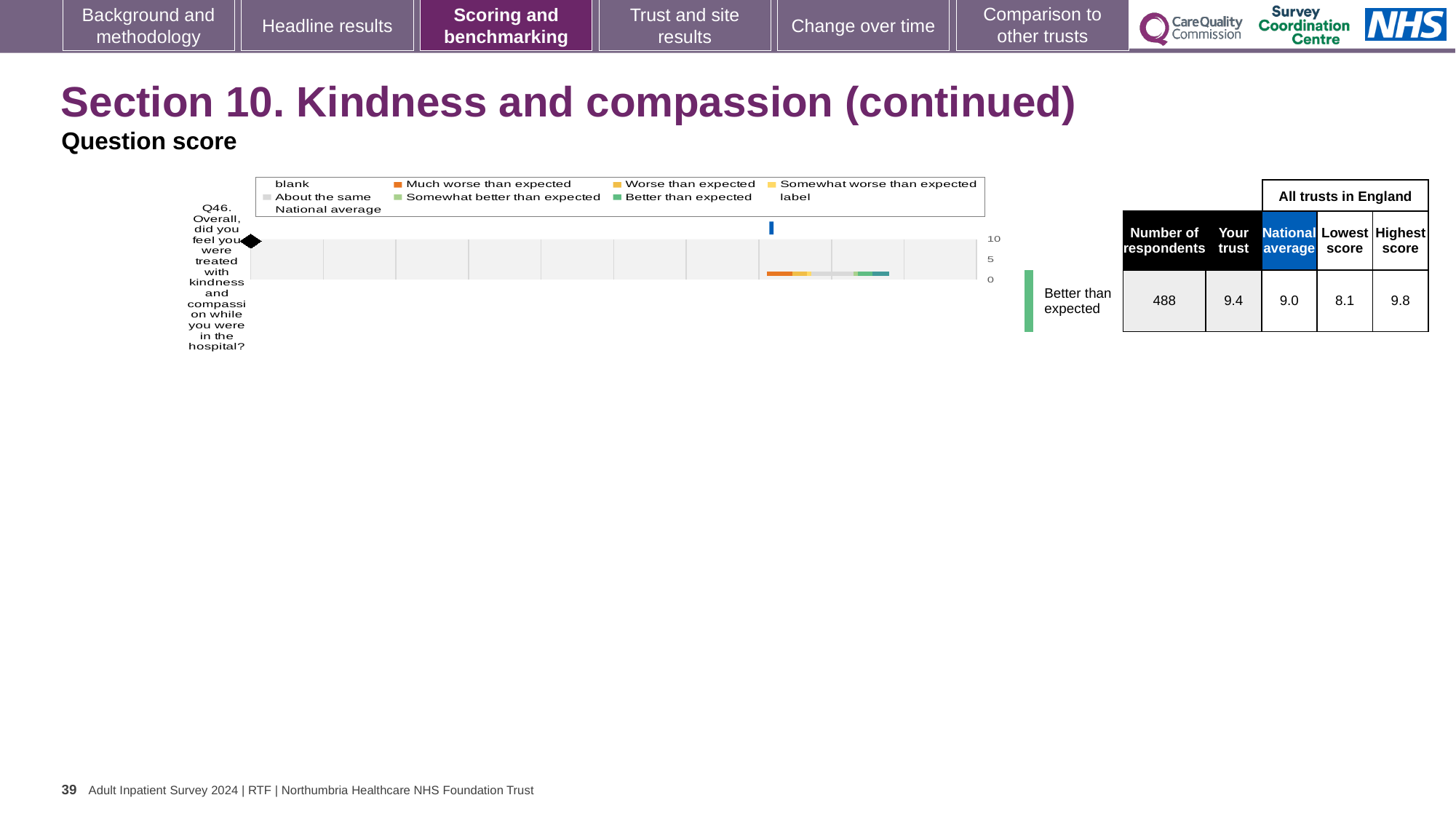
What is the difference between the 'Your trust' score and the national average for Q46? 0.4 What is the 'Your trust' score for Q46? 9.4 Which is larger for Q46, the 'Your trust' score or the national average? Your trust What benchmark rating is shown next to the chart for Q46? Better than expected What is the lowest score among all trusts in England for Q46? 8.1 How many questions (categories) are plotted in the chart? 1 What kind of chart is shown on the slide? bar chart What is the national average score for Q46? 9.0 Which question number is plotted in the chart? Q46 What is the difference between the highest and lowest scores among all trusts in England for Q46? 1.7 What is the number of respondents for Q46? 488 What is the highest score among all trusts in England for Q46? 9.8